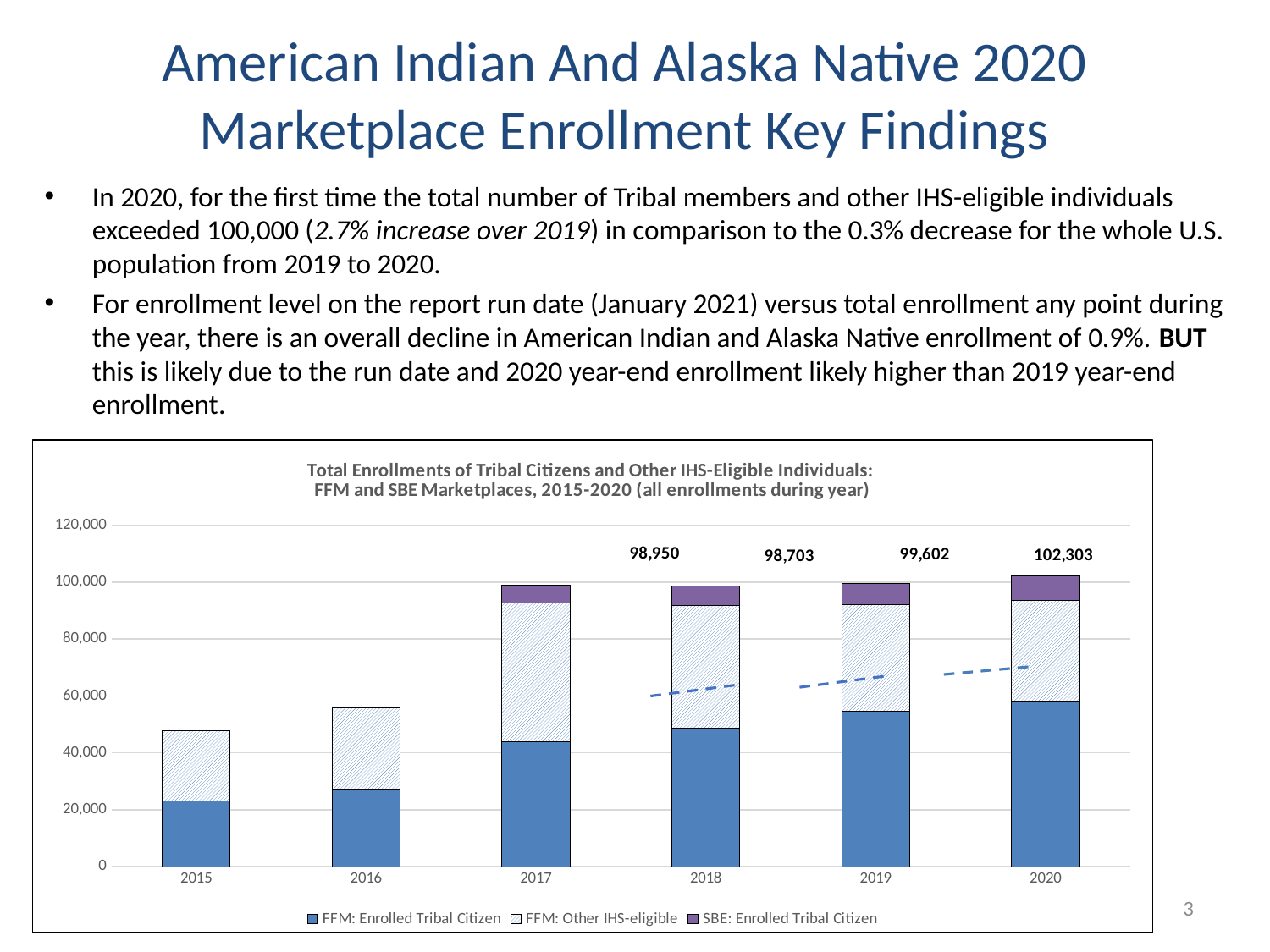
What is the total enrollment labeled for 2020? 102,303 What kind of chart is shown on the slide? Bar chart How many years are shown on the x axis of the chart? 6 What is the total enrollment labeled for 2017? 98,950 Which year has the highest total enrollment? 2020 Do the total enrollments generally rise or fall from 2015 to 2020? rise What is the total enrollment labeled for 2018? 98,703 Is the total enrollment for 2015 greater or less than 60,000? less Which year has the larger total enrollment, 2018 or 2019? 2019 How many series does the chart's legend list? 3 Which year has the lowest total enrollment? 2015 What is the difference between the total enrollment in 2020 and in 2019? 2,701